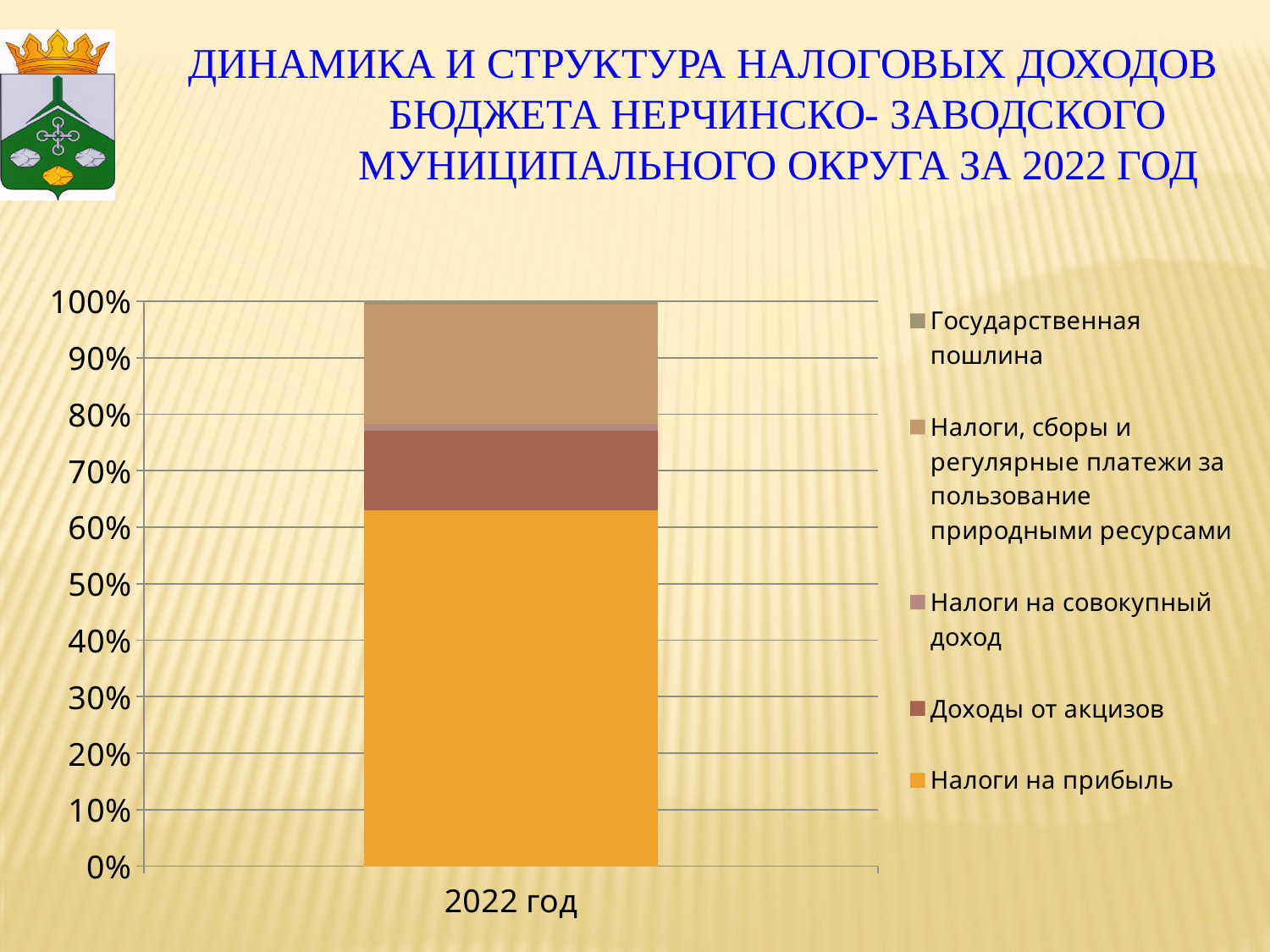
Is the share of Налоги на прибыль in the 2022 год bar greater or less than 70%? less Is the share of Налоги на прибыль in the 2022 год bar greater or less than 50%? greater Is the share of Доходы от акцизов in the 2022 год bar greater or less than 20%? less Which is larger in the 2022 год bar: Налоги, сборы и регулярные платежи за пользование природными ресурсами or Доходы от акцизов? Налоги, сборы и регулярные платежи за пользование природными ресурсами What colour represents Налоги на прибыль in the chart? Orange What kind of chart is shown on the slide? Stacked bar chart How many series does the chart legend list? 5 Which series makes up the largest share of the 2022 год bar? Налоги на прибыль How many categories are shown on the x axis of the chart? 1 Which is larger in the 2022 год bar: Налоги на прибыль or Доходы от акцизов? Налоги на прибыль What is the label of the single category on the x axis? 2022 год